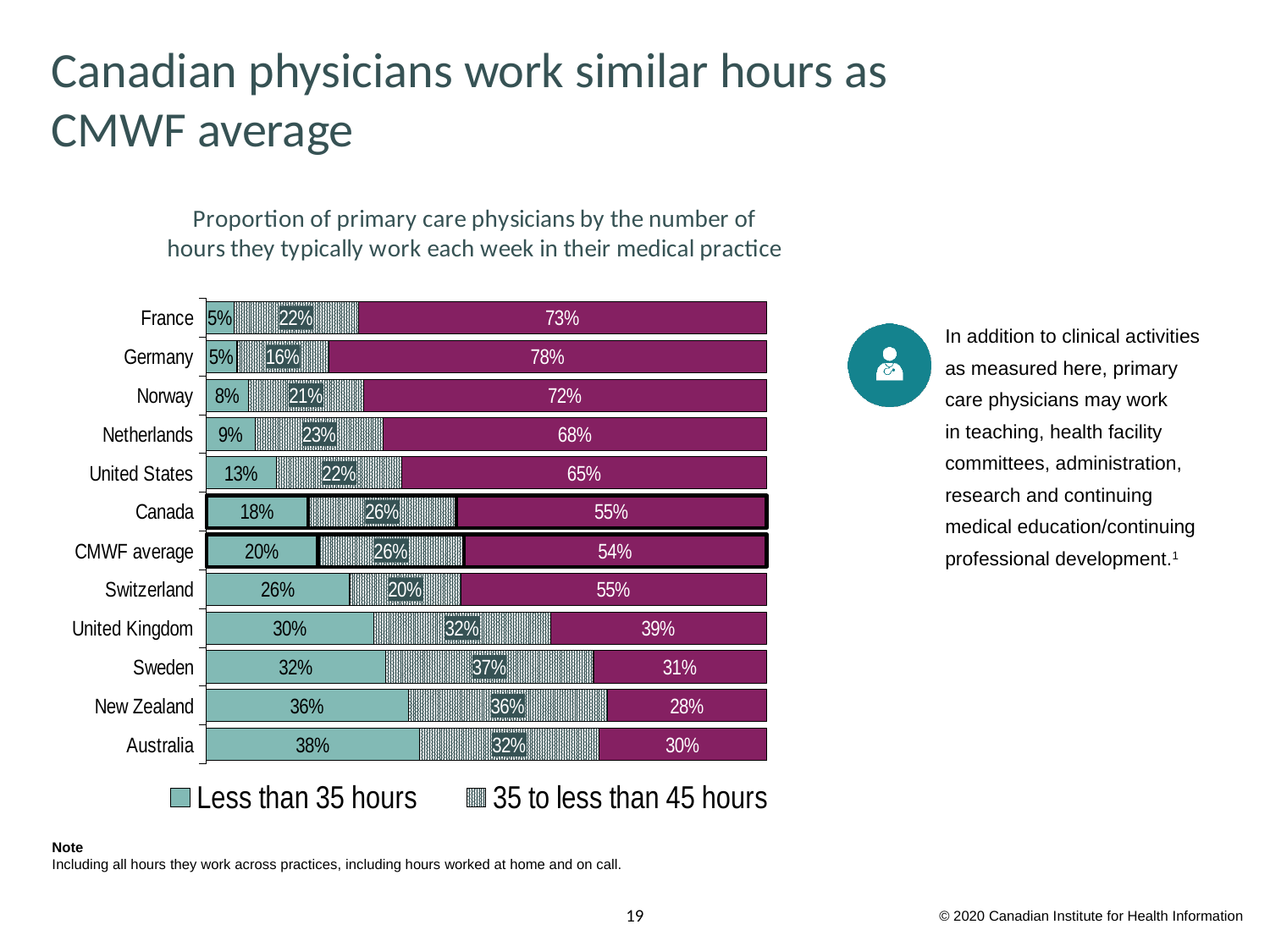
How many series does the legend list? 2 What percentage of primary care physicians in Germany fall into the largest (rightmost) segment of the bar? 78% Which is larger: the '35 to less than 45 hours' value for the United Kingdom or for Switzerland? United Kingdom What percentage of primary care physicians in Canada work less than 35 hours per week? 18% What is the value of the '35 to less than 45 hours' segment for Sweden? 37% Which country has the lowest value in the rightmost (purple) segment? New Zealand What is the difference between the 'Less than 35 hours' values for the CMWF average and Canada? 2% How many countries or groups are listed on the chart? 12 What is the title of the chart? Proportion of primary care physicians by the number of hours they typically work each week in their medical practice What is the total of the three segments for the United Kingdom bar? 101% Which country has the highest proportion of primary care physicians working less than 35 hours? Australia What kind of chart is shown on the slide? Stacked bar chart